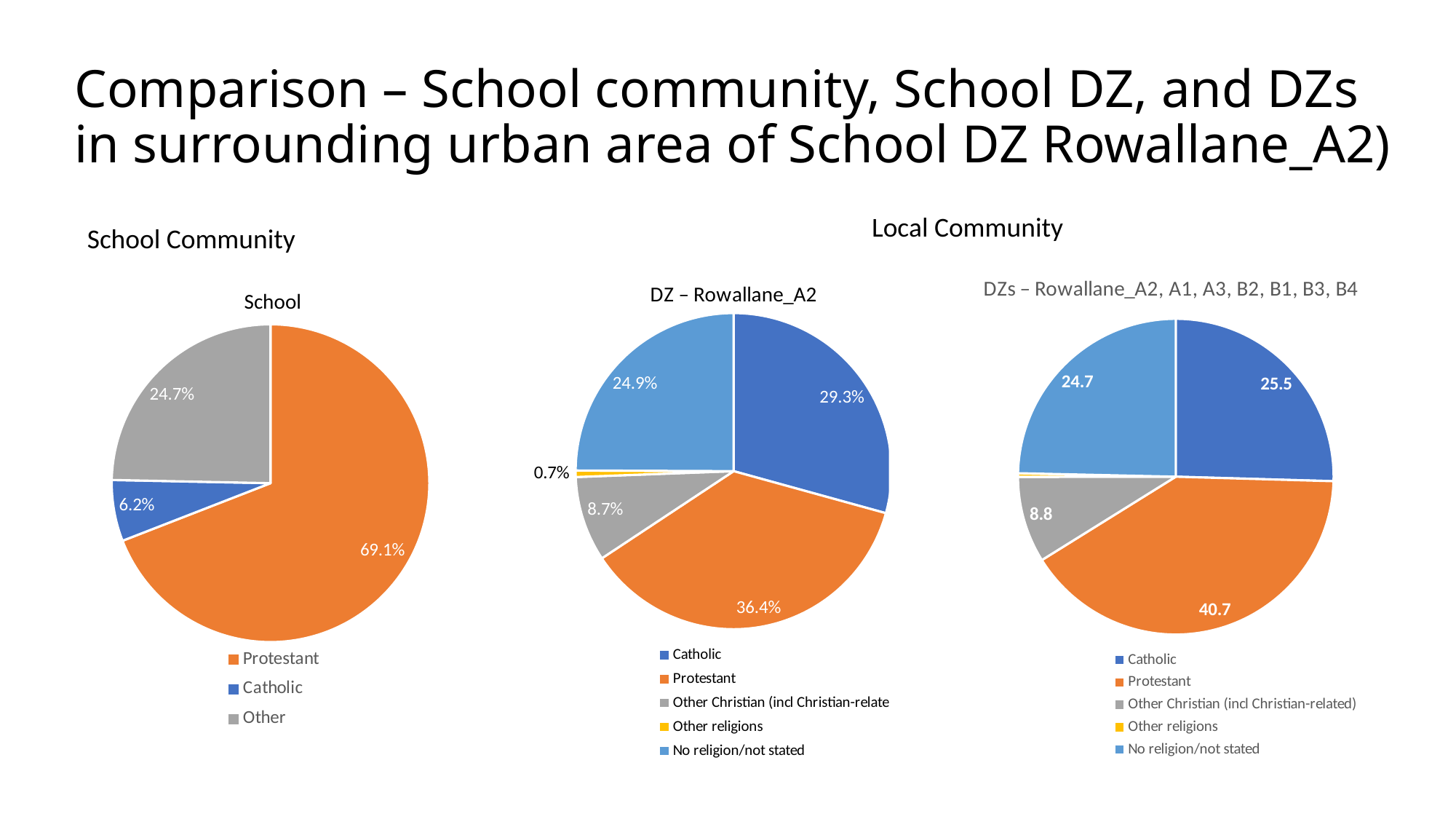
In the 'DZs – Rowallane_A2, A1, A3, B2, B1, B3, B4' pie chart, what is the value for Protestant? 40.7 How many categories does the legend of the 'DZ – Rowallane_A2' pie chart list? 5 In the 'DZs – Rowallane_A2, A1, A3, B2, B1, B3, B4' pie chart, what is the value for Other Christian (incl Christian-related)? 8.8 In the 'DZ – Rowallane_A2' pie chart, what percentage is Catholic? 29.3% In the 'School' pie chart, what percentage is Protestant? 69.1% In the 'DZ – Rowallane_A2' pie chart, what percentage is Other religions? 0.7% In the 'DZ – Rowallane_A2' pie chart, which category has the largest share? Protestant In the 'School' pie chart, which category has the smallest share? Catholic In the 'School' pie chart, what percentage is Catholic? 6.2% In the 'DZs – Rowallane_A2, A1, A3, B2, B1, B3, B4' pie chart, which is larger, Catholic or No religion/not stated? Catholic In the 'DZ – Rowallane_A2' pie chart, what is the difference between the Protestant and Catholic percentages? 7.1% What type of chart is the 'School' chart? Pie chart